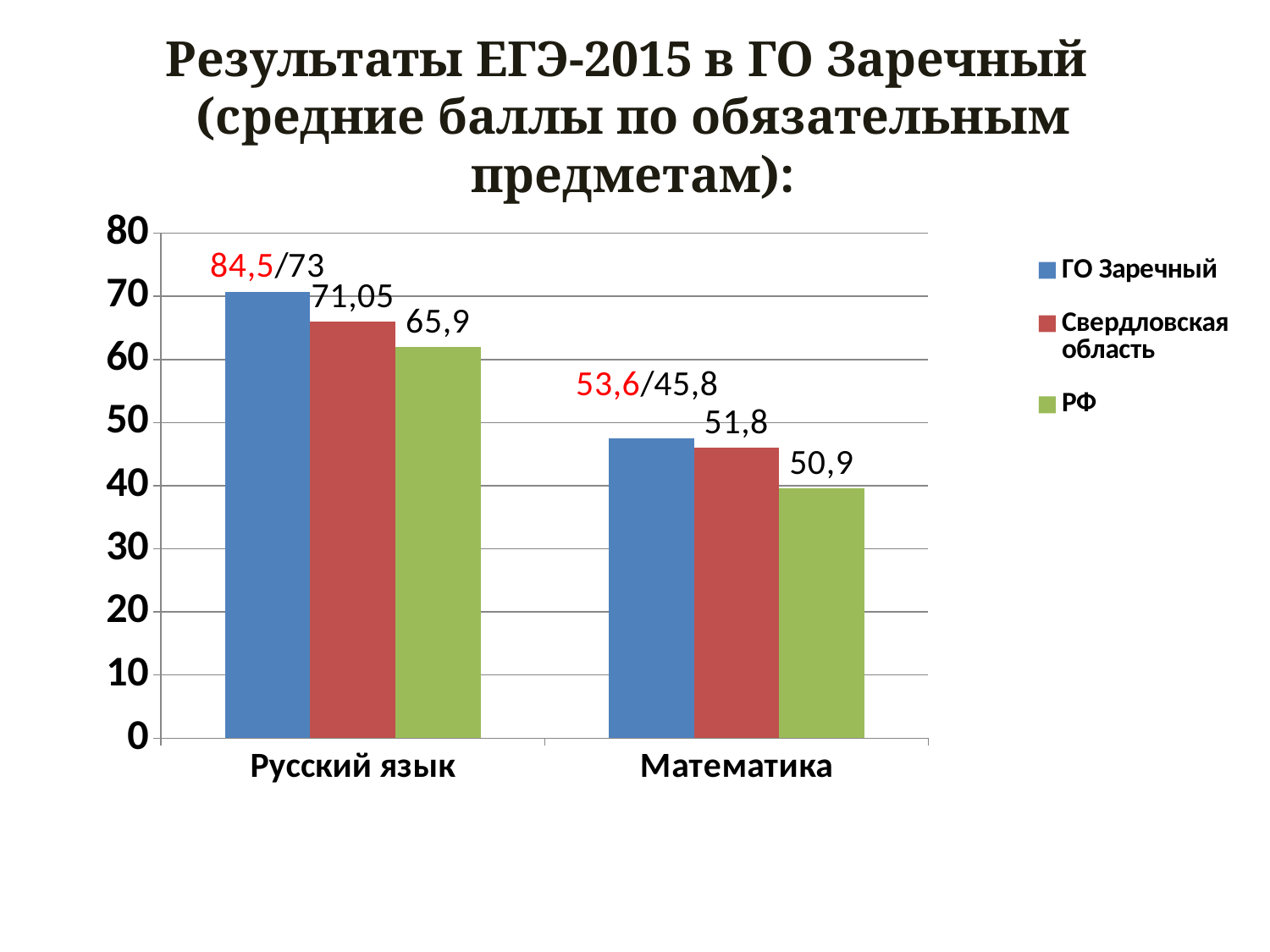
Which series are listed in the legend? ГО Заречный, Свердловская область, РФ Do the bars rise or fall from Русский язык to Математика? fall What value is labelled for Свердловская область in Русский язык? 71,05 Is the bar for ГО Заречный in Русский язык greater or less than 60? greater How many subject categories are shown on the x axis? 2 What is the difference between the labelled values for Свердловская область and РФ in Русский язык? 5,15 What kind of chart is shown on the slide? Bar chart How many series does the legend list? 3 What value is labelled for РФ in Математика? 50,9 Which series has the tallest bar in the Математика group? ГО Заречный What value is labelled for РФ in Русский язык? 65,9 What value is labelled for Свердловская область in Математика? 51,8